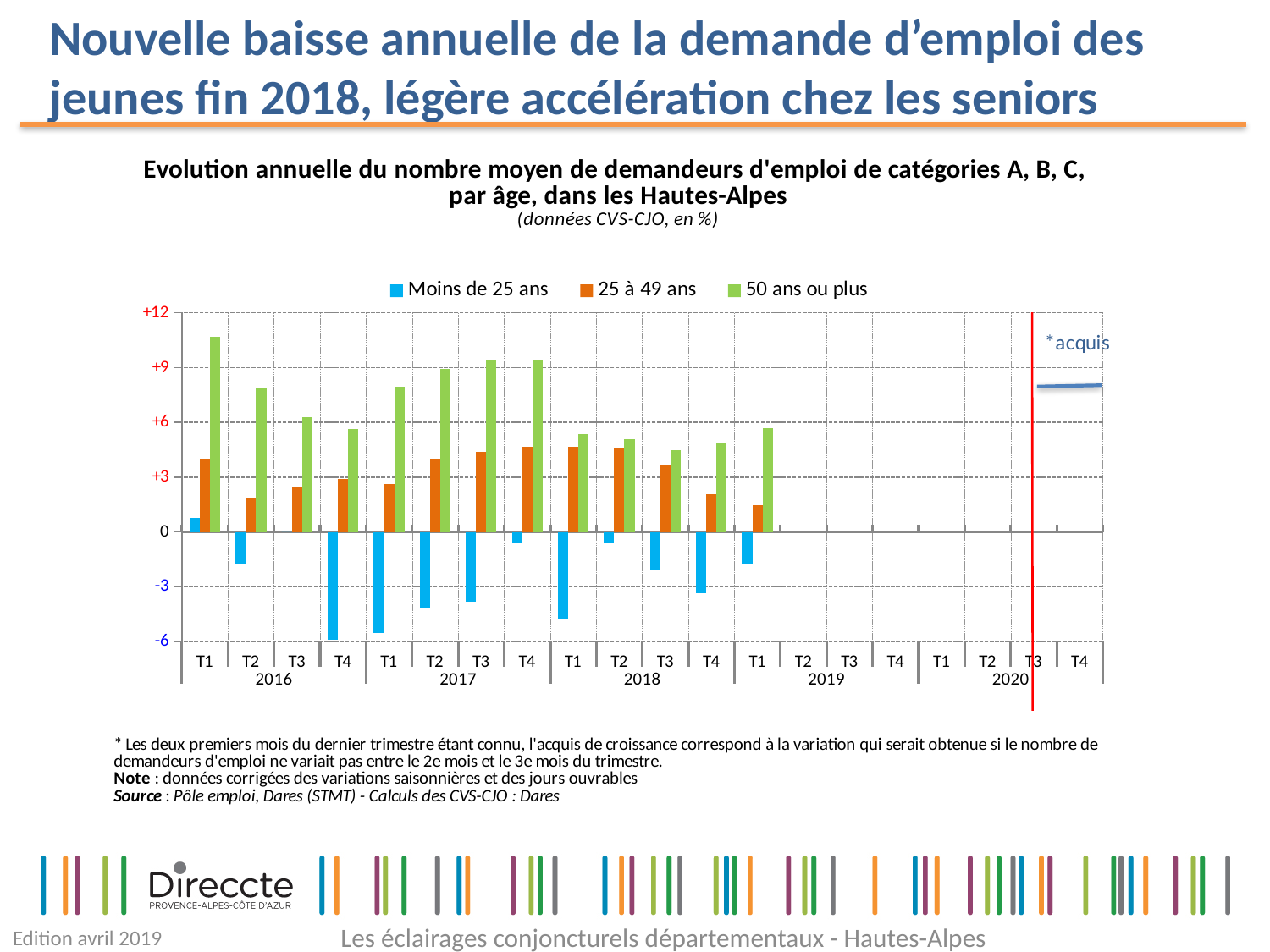
How many years are labeled on the x axis? 5 Is the value for '25 à 49 ans' in T1 2019 greater or less than +3? less Is the value for '50 ans ou plus' in T1 2016 greater or less than +9? greater How many series does the legend list? 3 Does the '50 ans ou plus' series rise or fall from T1 2016 to T3 2016? fall Which series has the highest value in T1 2016? 50 ans ou plus Is the value for 'Moins de 25 ans' in T4 2016 greater or less than -3? less What kind of chart is shown on the slide? bar chart In T2 2017, which is larger: the value for '25 à 49 ans' or for '50 ans ou plus'? 50 ans ou plus What colour represents the 'Moins de 25 ans' series? blue Does the '25 à 49 ans' series rise or fall from T1 2017 to T4 2017? rise In which quarter does the '50 ans ou plus' series reach its highest value? T1 2016